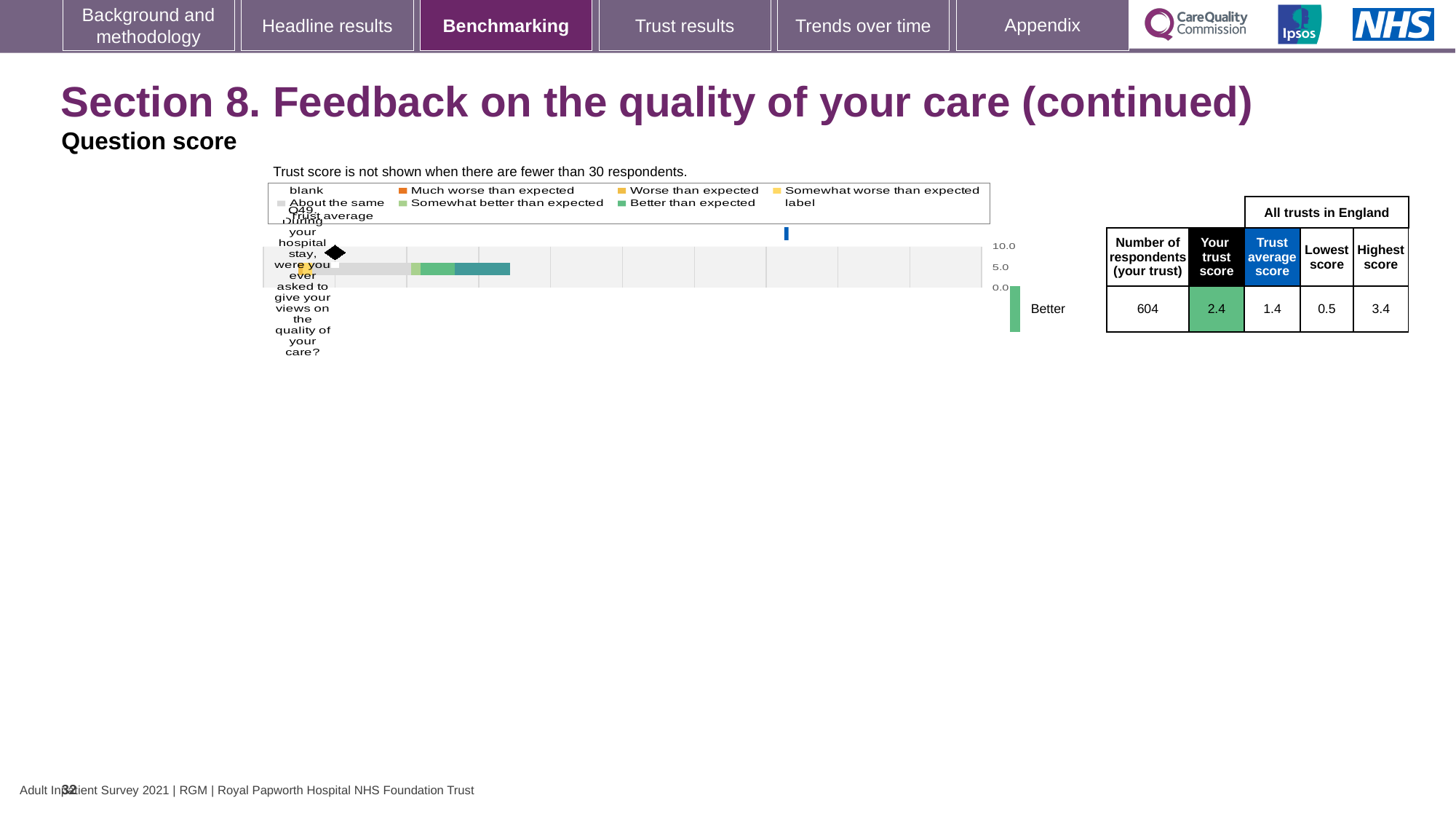
What kind of chart is used to show the Q49 benchmarking result? bar chart How many respondents from the trust answered Q49, according to the table beside the chart? 604 In the table beside the chart, what is the trust's score for Q49? 2.4 Which question is plotted on the benchmarking chart? Q49 What is the difference between the trust's score (2.4) and the trust average score (1.4) for Q49? 1.0 What label is shown next to the small green bar to the right of the chart? Better What is the highest tick value shown on the chart's horizontal axis? 10.0 In the table beside the chart, what is the highest score among all trusts in England for Q49? 3.4 In the table beside the chart, what is the trust average score for Q49? 1.4 Is the trust's score for Q49 (2.4) larger or smaller than the trust average score (1.4)? larger In the table beside the chart, what is the lowest score among all trusts in England for Q49? 0.5 How many questions (categories) are plotted on the benchmarking chart? 1